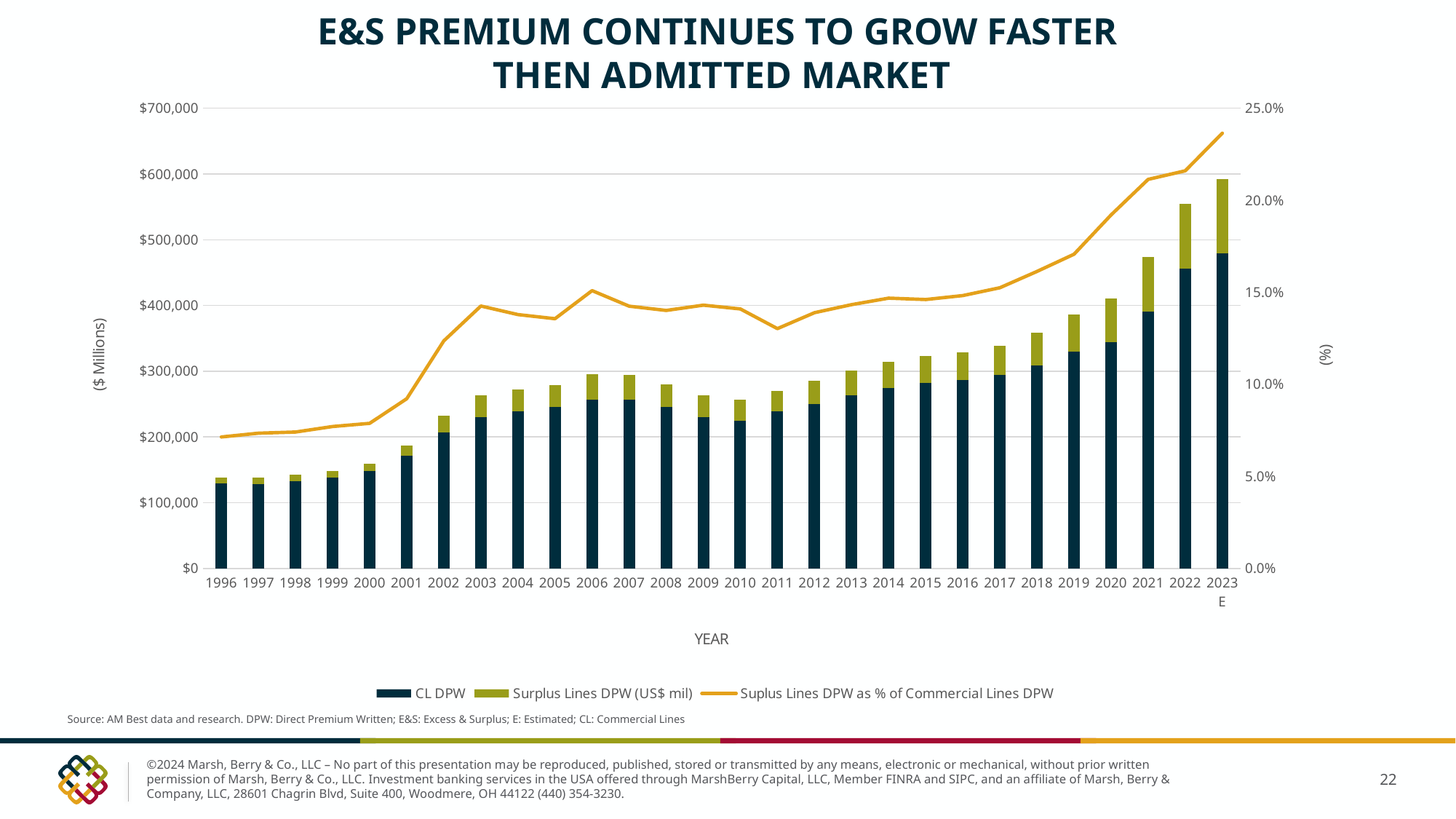
Does the Surplus Lines DPW as % of Commercial Lines DPW line generally rise or fall from 2011 to 2023 E? rise How many series does the chart legend list? 3 Is the Surplus Lines DPW as % of Commercial Lines DPW for 2023 E greater or less than 20.0%? greater Is the CL DPW value for 2023 E greater or less than $400,000? greater In which year does the Surplus Lines DPW as % of Commercial Lines DPW line reach its highest point? 2023 E How many years are shown on the x axis of the chart? 28 What is the label of the x axis of the chart? YEAR Is the Surplus Lines DPW as % of Commercial Lines DPW for 1996 greater or less than 10.0%? less Which year has the tallest stacked bar (CL DPW plus Surplus Lines DPW)? 2023 E Which year has the larger CL DPW bar, 2006 or 2010? 2006 What kind of chart is shown on the slide? Bar chart with a line